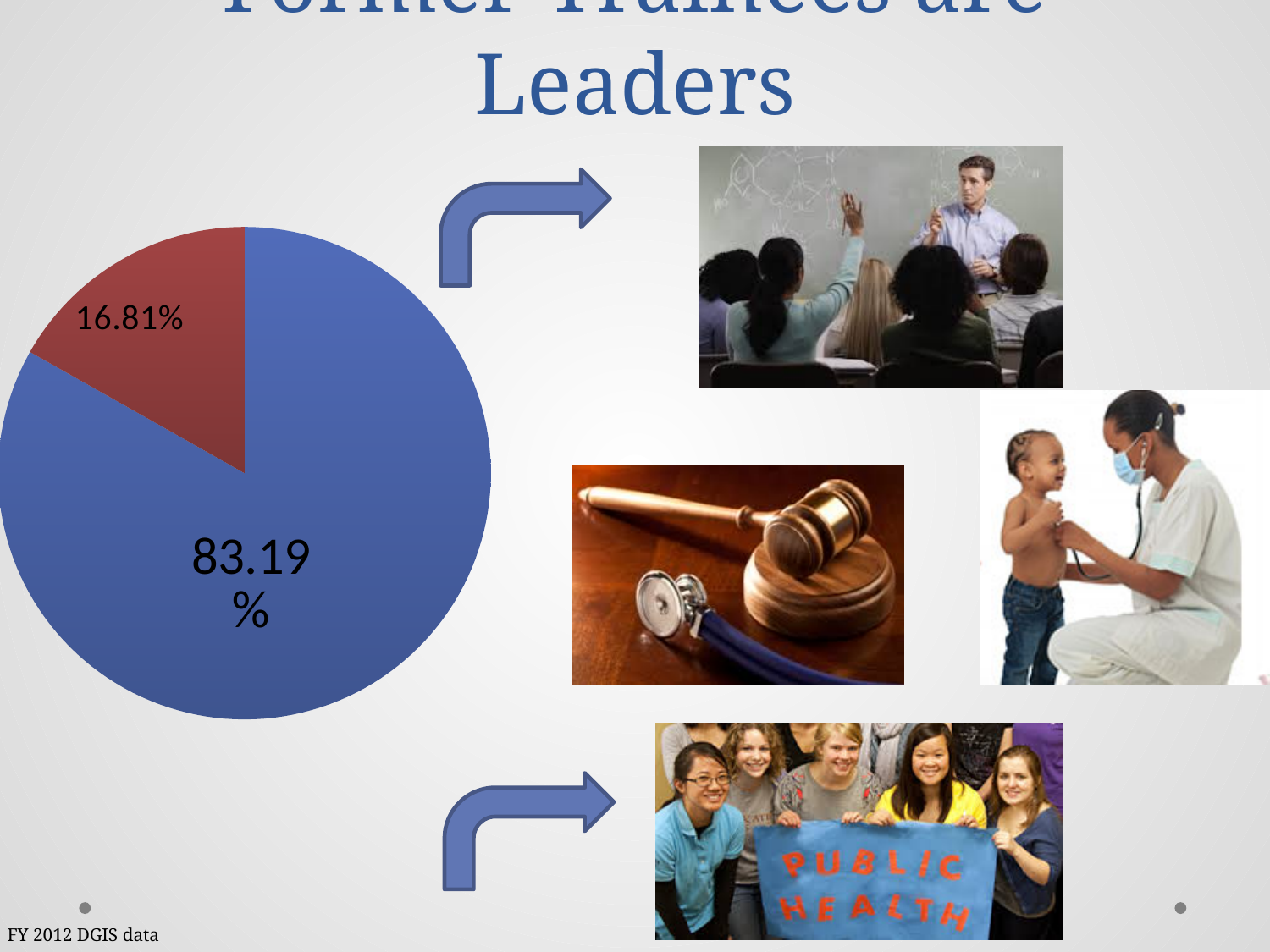
What percentage is shown on the blue slice of the pie chart? 83.19% How many slices does the pie chart have? 2 What data source is cited at the bottom of the slide for the chart? FY 2012 DGIS data Which is larger in the pie chart, the blue slice or the red slice? the blue slice What colour is the slice labelled 16.81% in the pie chart? red What percentage is shown on the red slice of the pie chart? 16.81% What kind of chart is shown on the slide? pie chart What share of the pie does the red slice represent? 16.81% What is the difference in percentage points between the blue slice and the red slice of the pie chart? 66.38 Which slice of the pie chart is the largest? the blue slice (83.19%) Which slice of the pie chart is the smallest? the red slice (16.81%) Is the value of the blue slice greater or less than 50%? greater